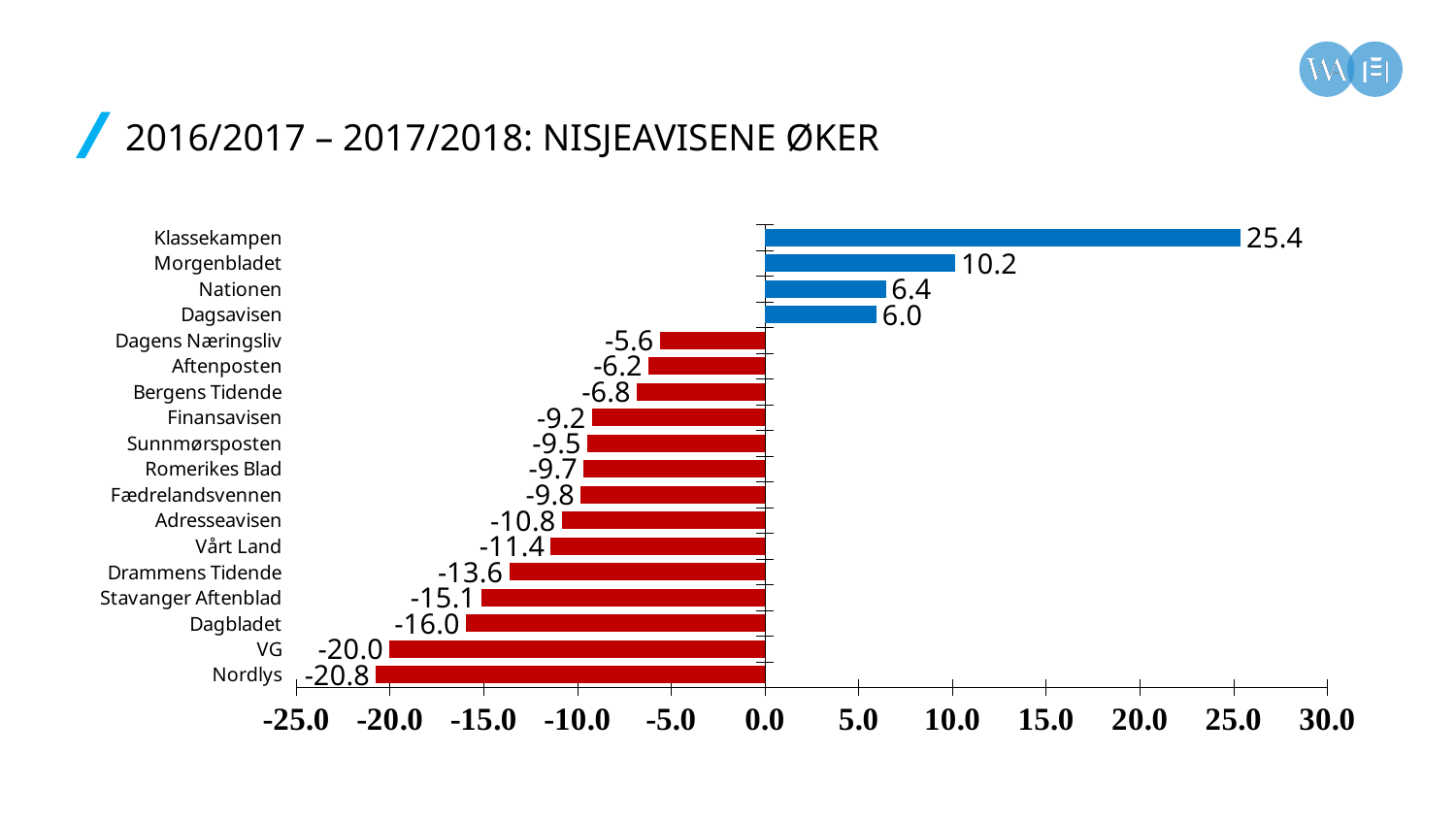
How many newspapers are shown in the chart? 18 What is the value for Nordlys? -20.8 Is the value for VG greater or less than -15.0? less What is the title of the slide? 2016/2017 – 2017/2018: NISJEAVISENE ØKER Which newspaper has the lowest value? Nordlys What is the value for Dagsavisen? 6.0 What is the value for Aftenposten? -6.2 Which newspaper has the highest value? Klassekampen What kind of chart is shown on the slide? Bar chart What is the value for Klassekampen? 25.4 What is the difference between the values for Klassekampen and Morgenbladet? 15.2 Which has a larger value, Nationen or Dagbladet? Nationen